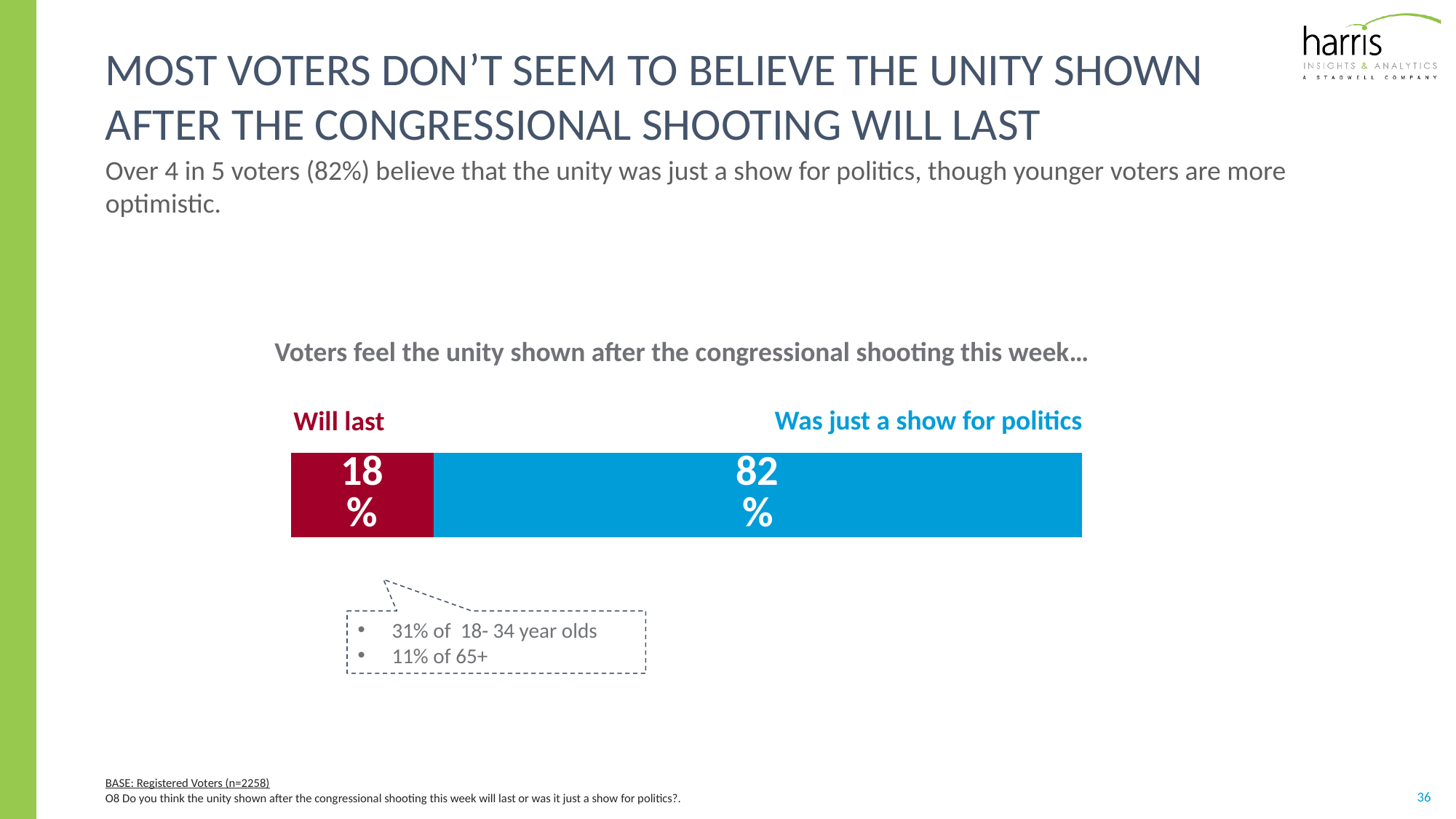
What is the difference in percentage points between 'Was just a show for politics' and 'Will last'? 64 What is the total of the two segments in the stacked bar? 100% How many response categories are shown in the bar? 2 What percentage of voters feel the unity was just a show for politics? 82% Which response has the larger share: 'Will last' or 'Was just a show for politics'? Was just a show for politics What colour is the 'Will last' segment of the bar? Red What is the title of the chart? Voters feel the unity shown after the congressional shooting this week… Which response has the smallest share in the chart? Will last Which response has the largest share in the chart? Was just a show for politics What percentage of voters feel the unity shown after the congressional shooting will last? 18% According to the callout, what percentage of 18-34 year olds feel the unity will last? 31% What kind of chart is shown on the slide? Stacked bar chart